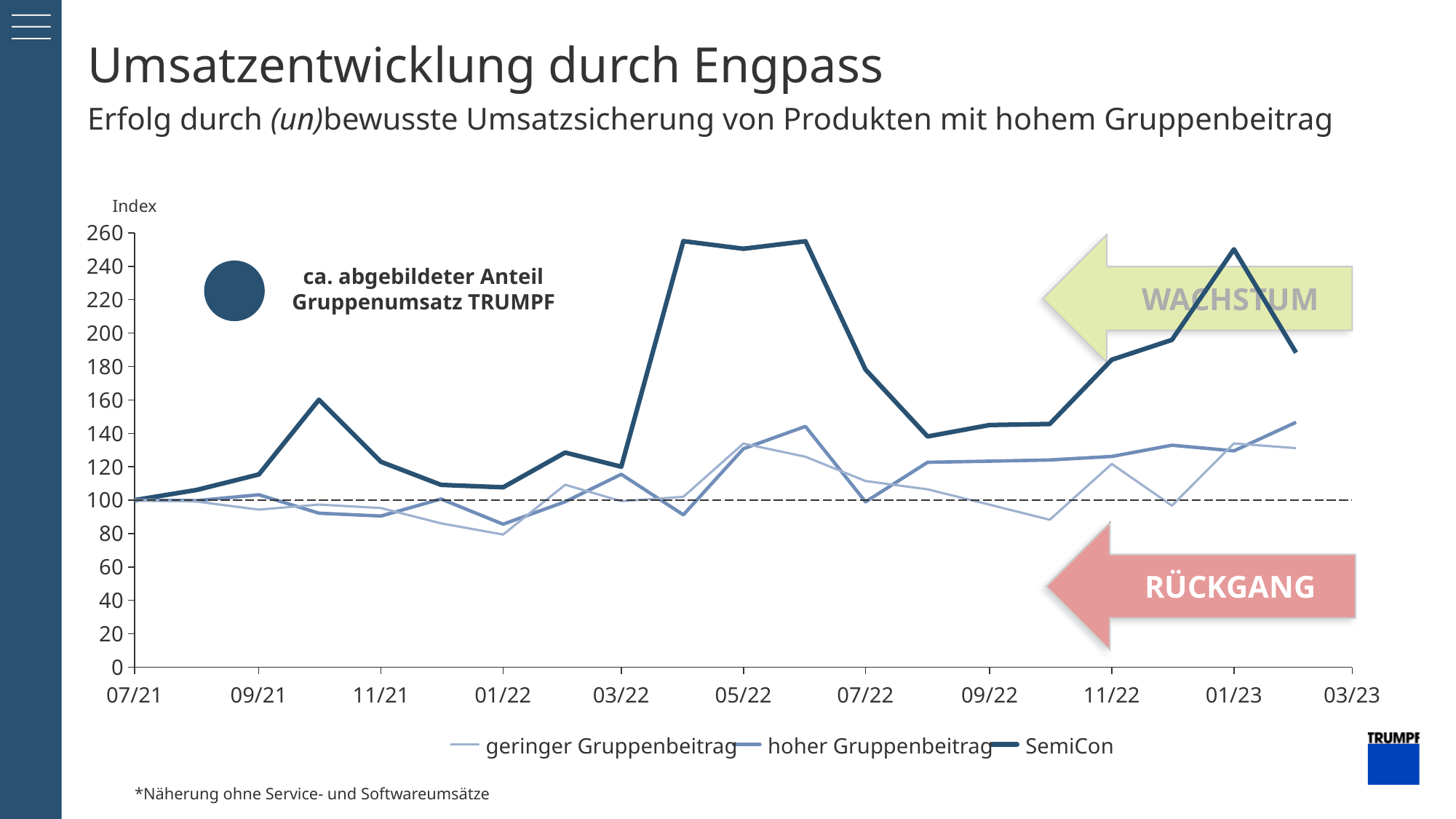
What kind of chart is shown on the slide? line chart Is the value for geringer Gruppenbeitrag at 01/22 greater or less than 100? less Is the value for hoher Gruppenbeitrag at 11/22 greater or less than 100? greater Is the value for SemiCon at 01/23 greater or less than 200? greater What are the three series named in the legend? geringer Gruppenbeitrag, hoher Gruppenbeitrag, SemiCon Does the SemiCon line rise or fall between 09/22 and 01/23? rise How many series does the legend list? 3 Which series reaches the highest value anywhere on the chart? SemiCon What is the label on the vertical axis? Index At 05/22, which is larger: SemiCon or hoher Gruppenbeitrag? SemiCon